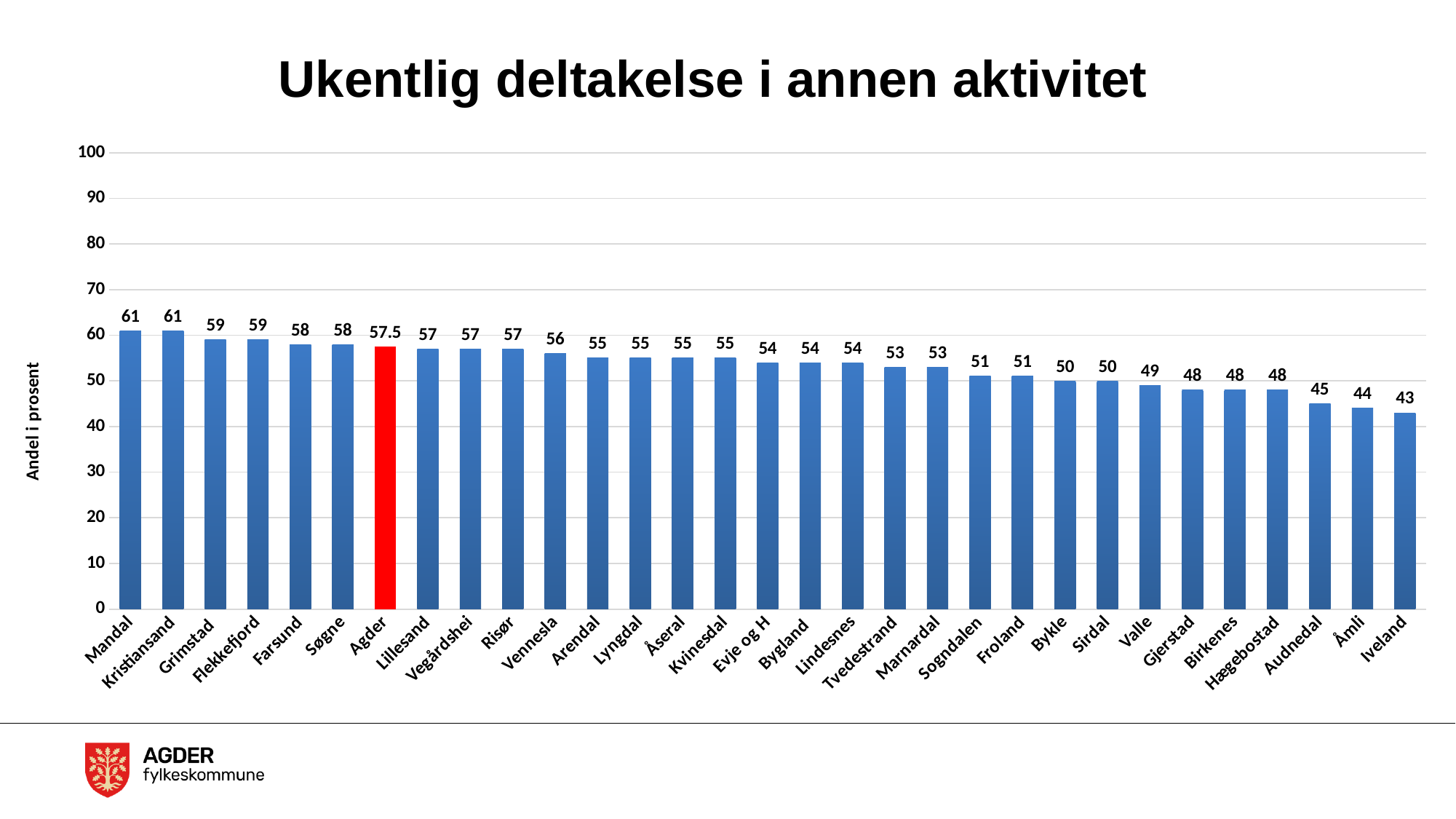
Which category has the lowest value? Iveland What is the difference between the values for Agder and Audnedal? 12.5 What kind of chart is this? bar chart What is the value for Iveland? 43 Which is larger, the value for Grimstad or the value for Valle? Grimstad Do the values rise or fall from left to right along the x axis? fall How many categories are shown on the x axis? 31 What is the value for Froland? 51 Which bar is coloured red instead of blue? Agder What is the difference between the values for Mandal and Iveland? 18 What is the value for Agder? 57.5 What is the value for Vennesla? 56